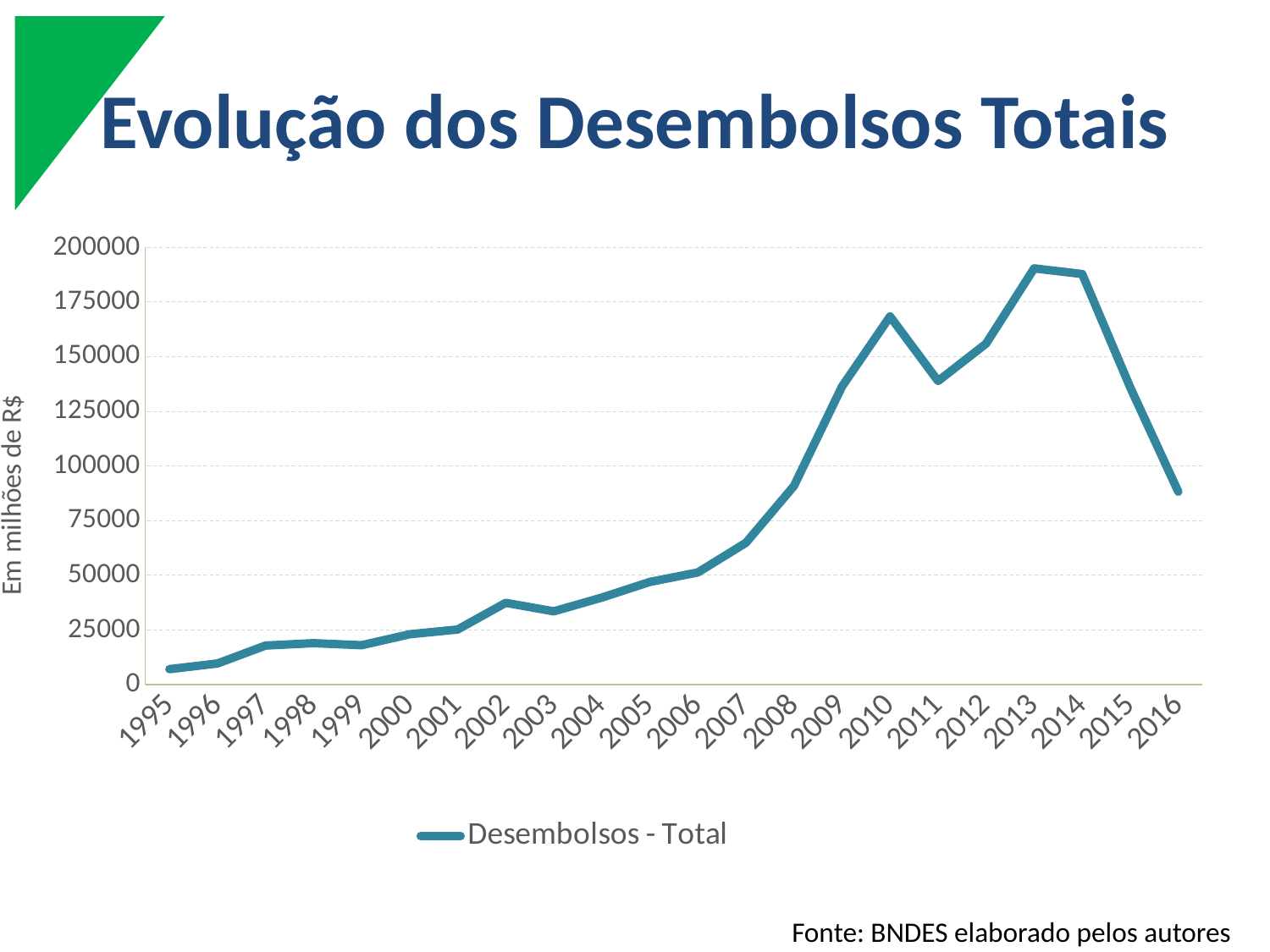
Do the values rise or fall from 2014 to 2016? Fall In which year is the value of Desembolsos - Total lowest? 1995 How many series does the legend list? 1 What type of chart is shown on the slide? Line chart Is the value for 2016 greater or less than 100000? less In which year is the value of Desembolsos - Total highest? 2013 Is the value for 2007 greater or less than 50000? greater How many years are plotted along the x axis of the chart? 22 Is the value for 2013 greater or less than 175000? greater What is the label on the vertical axis of the chart? Em milhões de R$ Which year has the larger value, 2010 or 2011? 2010